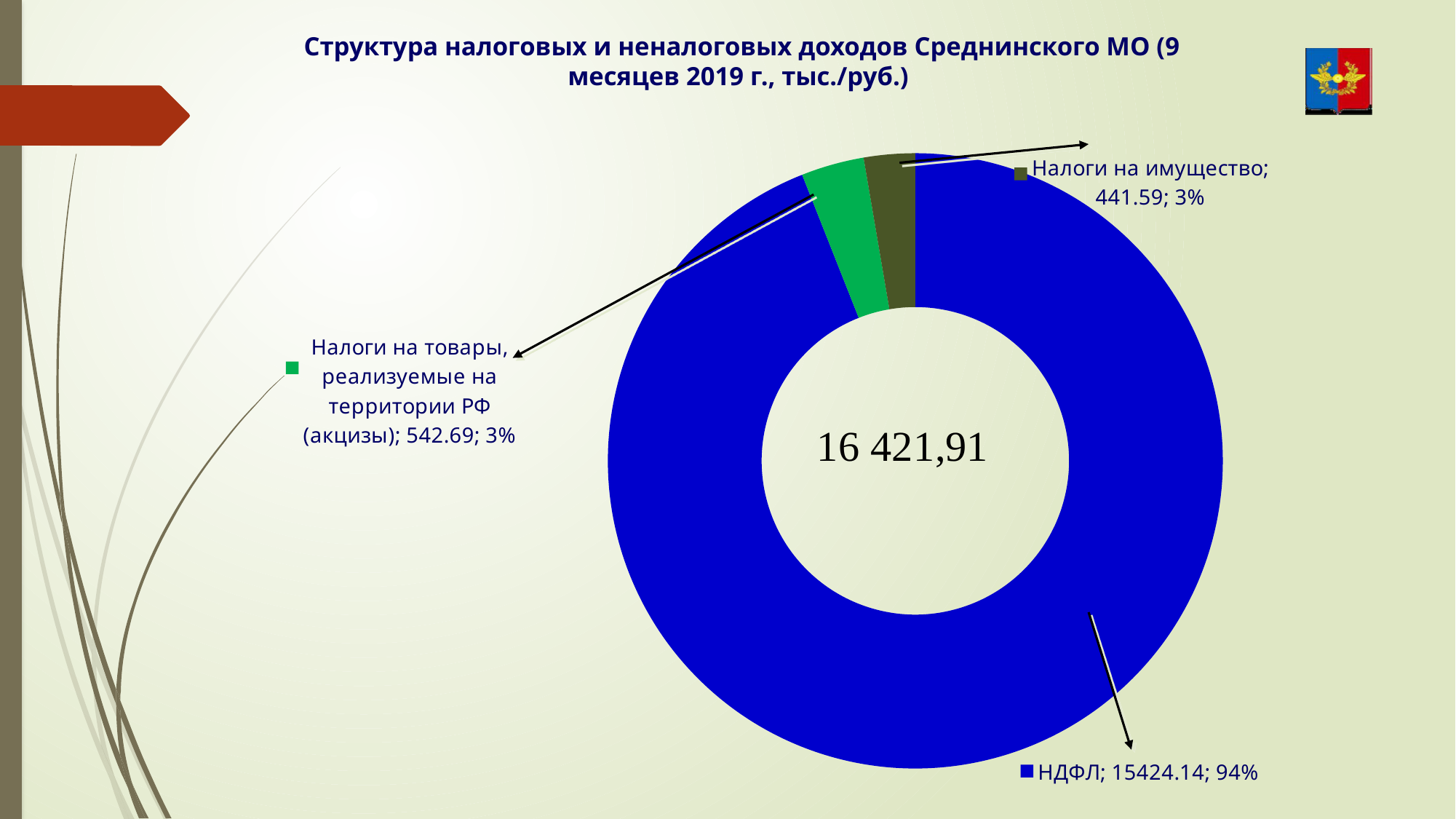
Which category has the largest share of the chart? НДФЛ What is the value for Налоги на товары, реализуемые на территории РФ (акцизы)? 542.69 What is the value for Налоги на имущество? 441.59 What share of the chart does Налоги на имущество account for? 3% How many categories does the chart show? 3 Which category has the smallest value? Налоги на имущество What number is printed in the centre of the doughnut chart? 16 421,91 What is the difference between the value for акцизы and the value for Налоги на имущество? 101.1 Which is larger: the value for акцизы or the value for Налоги на имущество? Акцизы (542.69) What is the value for НДФЛ? 15424.14 What share of the chart does НДФЛ account for? 94% What kind of chart is shown on the slide? Doughnut (pie) chart